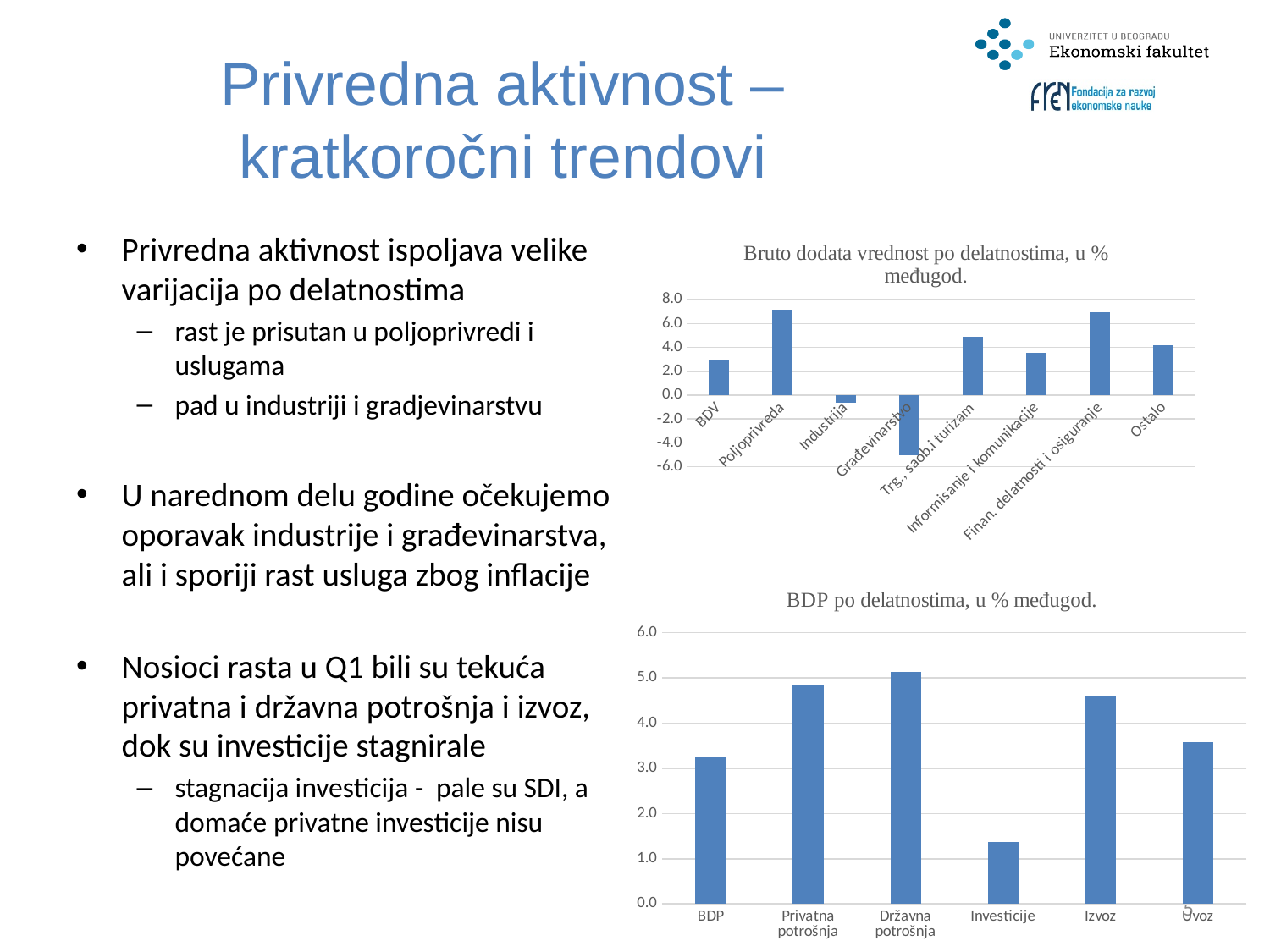
In the top chart (Bruto dodata vrednost po delatnostima), is the value for Građevinarstvo greater or less than -4.0? less In the top chart (Bruto dodata vrednost po delatnostima), how many categories are shown on the x axis? 8 In the bottom chart (BDP po delatnostima), which category has the lowest value? Investicije In the top chart (Bruto dodata vrednost po delatnostima), which category has the highest value? Poljoprivreda What kind of chart is the top chart titled "Bruto dodata vrednost po delatnostima, u % međugod."? bar chart In the top chart (Bruto dodata vrednost po delatnostima), which is larger, the value for Industrija or the value for Ostalo? Ostalo In the bottom chart (BDP po delatnostima), which is larger, the value for Izvoz or the value for Uvoz? Izvoz What kind of chart is the bottom chart titled "BDP po delatnostima, u % međugod."? bar chart In the bottom chart (BDP po delatnostima), how many categories are shown on the x axis? 6 In the top chart (Bruto dodata vrednost po delatnostima), is the value for Poljoprivreda greater or less than 6.0? greater In the top chart (Bruto dodata vrednost po delatnostima), which category has the lowest value? Građevinarstvo